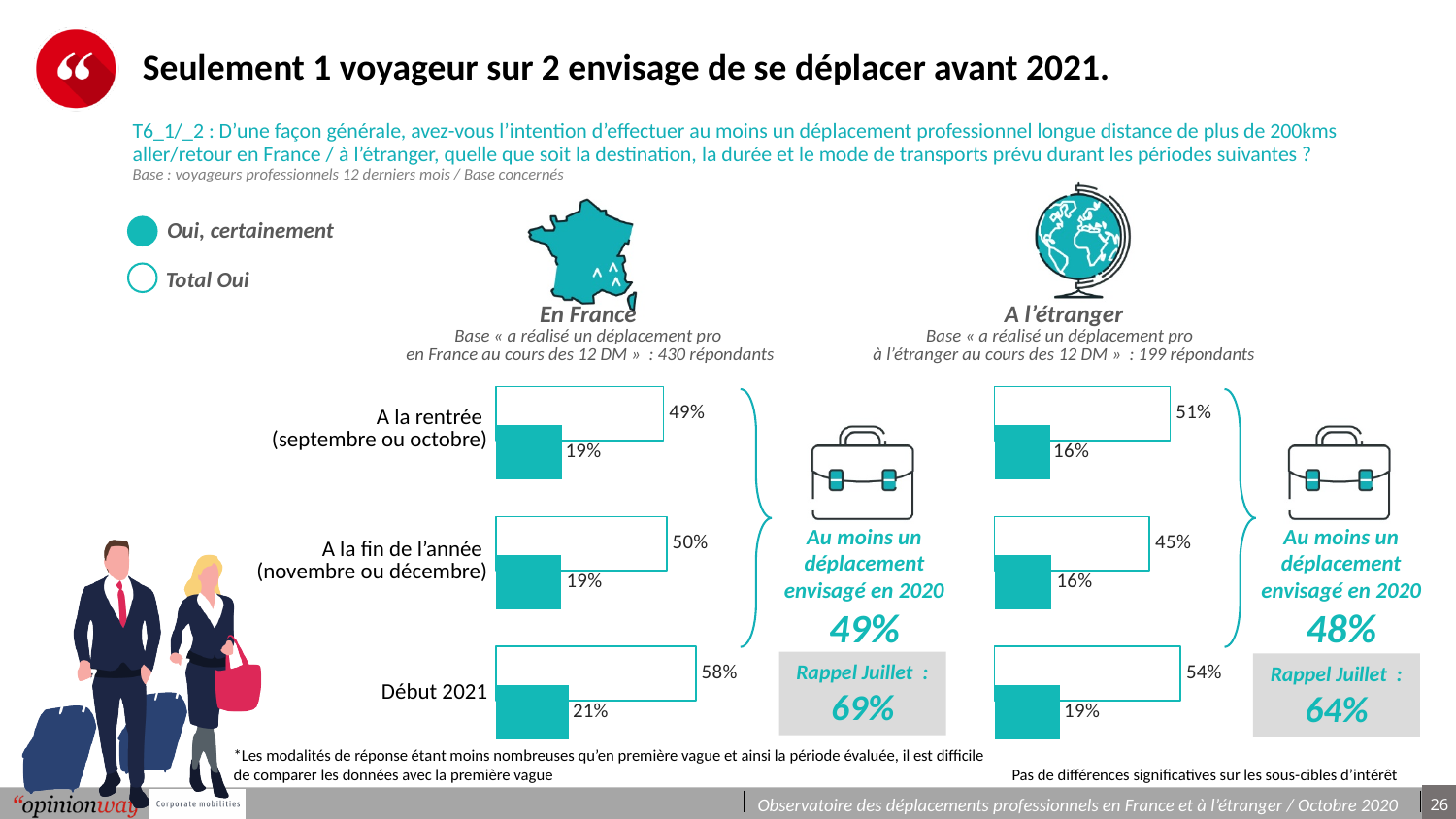
How many periods are shown in the 'En France' chart? 3 Which is larger: the 'Total Oui' value for Début 2021 in the 'En France' chart or in the 'A l'étranger' chart? En France What type of chart is used for the 'A l'étranger' data? Bar chart What is the base (number of respondents) for the 'A l'étranger' chart? 199 répondants In the 'En France' chart, do the 'Total Oui' values rise or fall from A la rentrée to Début 2021? Rise In the 'A l'étranger' chart, what is the 'Oui, certainement' value for A la fin de l'année (novembre ou décembre)? 16% In the 'A l'étranger' chart, which period has the lowest 'Total Oui' value? A la fin de l'année (novembre ou décembre) In the 'A l'étranger' chart, what is the 'Total Oui' value for A la rentrée (septembre ou octobre)? 51% In the 'En France' chart, which period has the highest 'Total Oui' value? Début 2021 How many series does the legend list for the charts? 2 In the 'En France' chart, what is the difference between the 'Total Oui' and 'Oui, certainement' values for Début 2021? 37 percentage points In the 'En France' chart, what is the 'Total Oui' value for Début 2021? 58%